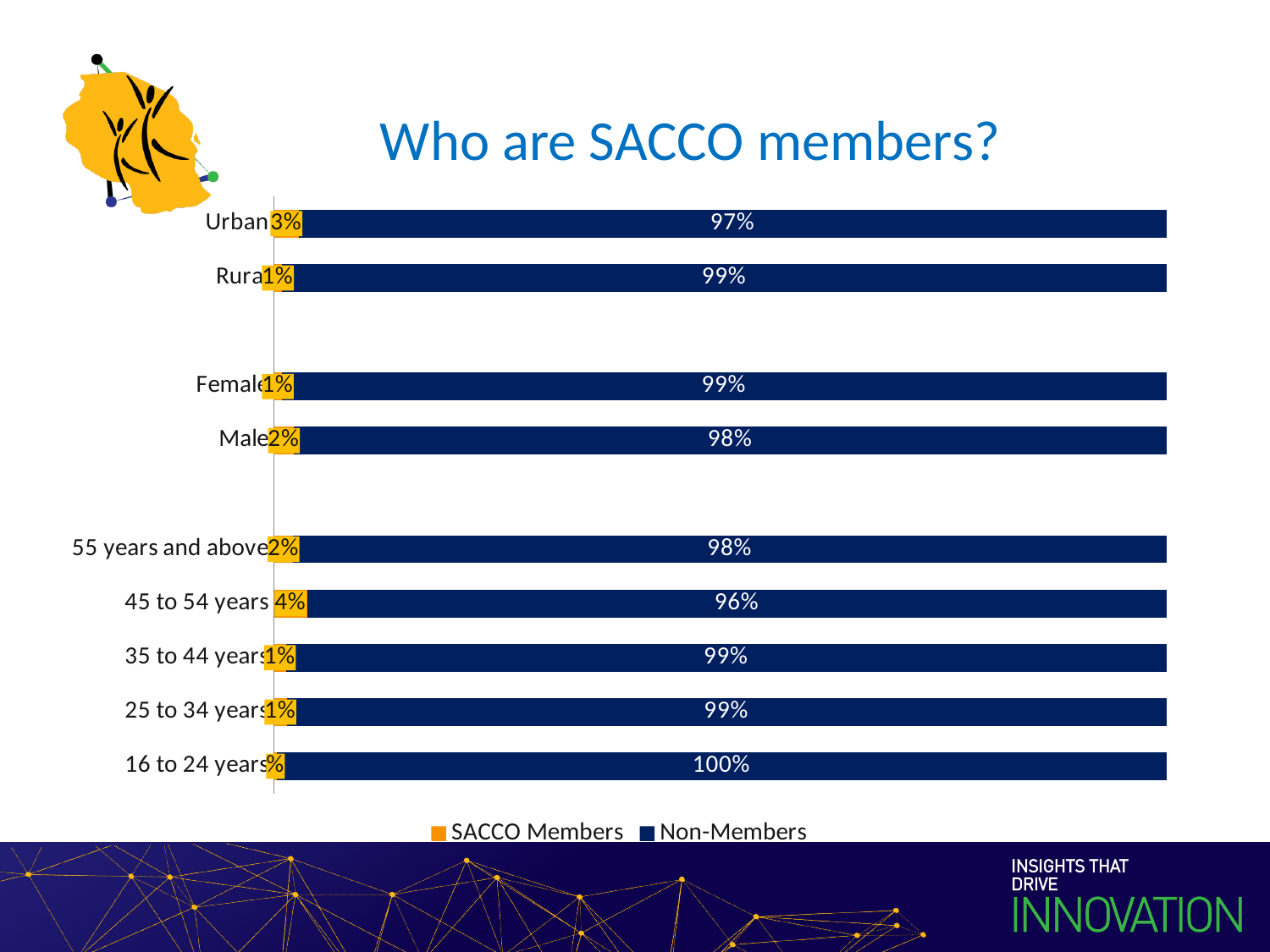
How many categories are shown in the chart? 9 What is the Non-Members value for 45 to 54 years? 96% What is the SACCO Members value for Male? 2% What is the Non-Members value for 16 to 24 years? 100% What is the SACCO Members value for Urban? 3% Which category has the highest SACCO Members value? 45 to 54 years Which has a larger SACCO Members value, Urban or Male? Urban What kind of chart is shown on the slide? Stacked bar chart What is the total of the stacked bar for Urban? 100% How many series does the legend list? 2 Which category has the lowest Non-Members value? 45 to 54 years What is the difference between the SACCO Members values for Urban and Rural? 2 percentage points